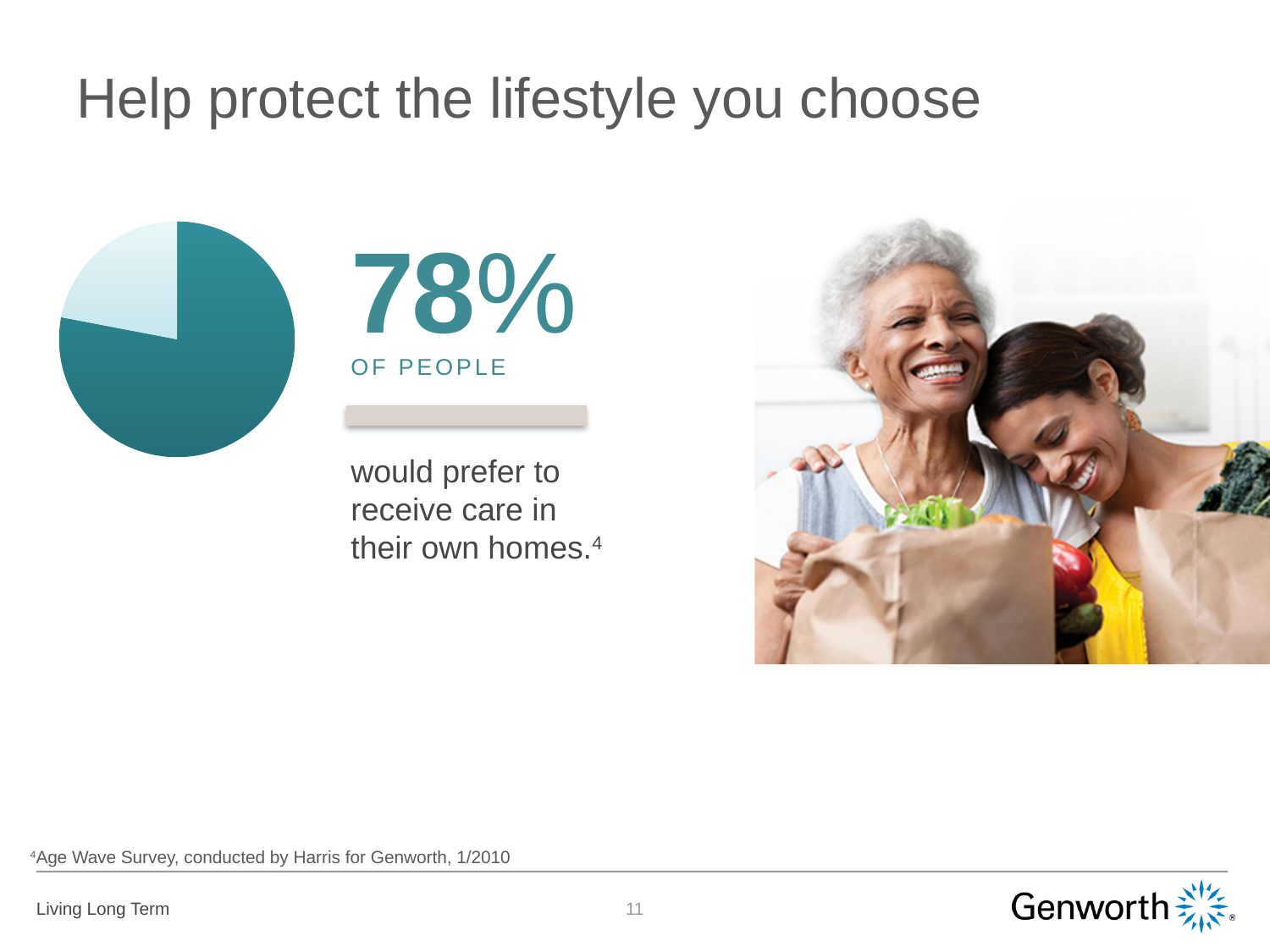
What is the title of the slide containing the pie chart? Help protect the lifestyle you choose What share of the pie does the light slice represent? 22% Which slice of the pie chart is larger, the dark teal slice or the light slice? the dark teal slice What share of the pie does the dark teal slice represent? 78% Which slice of the pie chart is the smallest? the light slice What percentage of people would prefer to receive care in their own homes, according to the slide? 78% How many slices does the pie chart have? 2 What source is cited for the 78% figure shown next to the pie chart? Age Wave Survey, conducted by Harris for Genworth, 1/2010 What kind of chart is shown on the left of the slide? pie chart